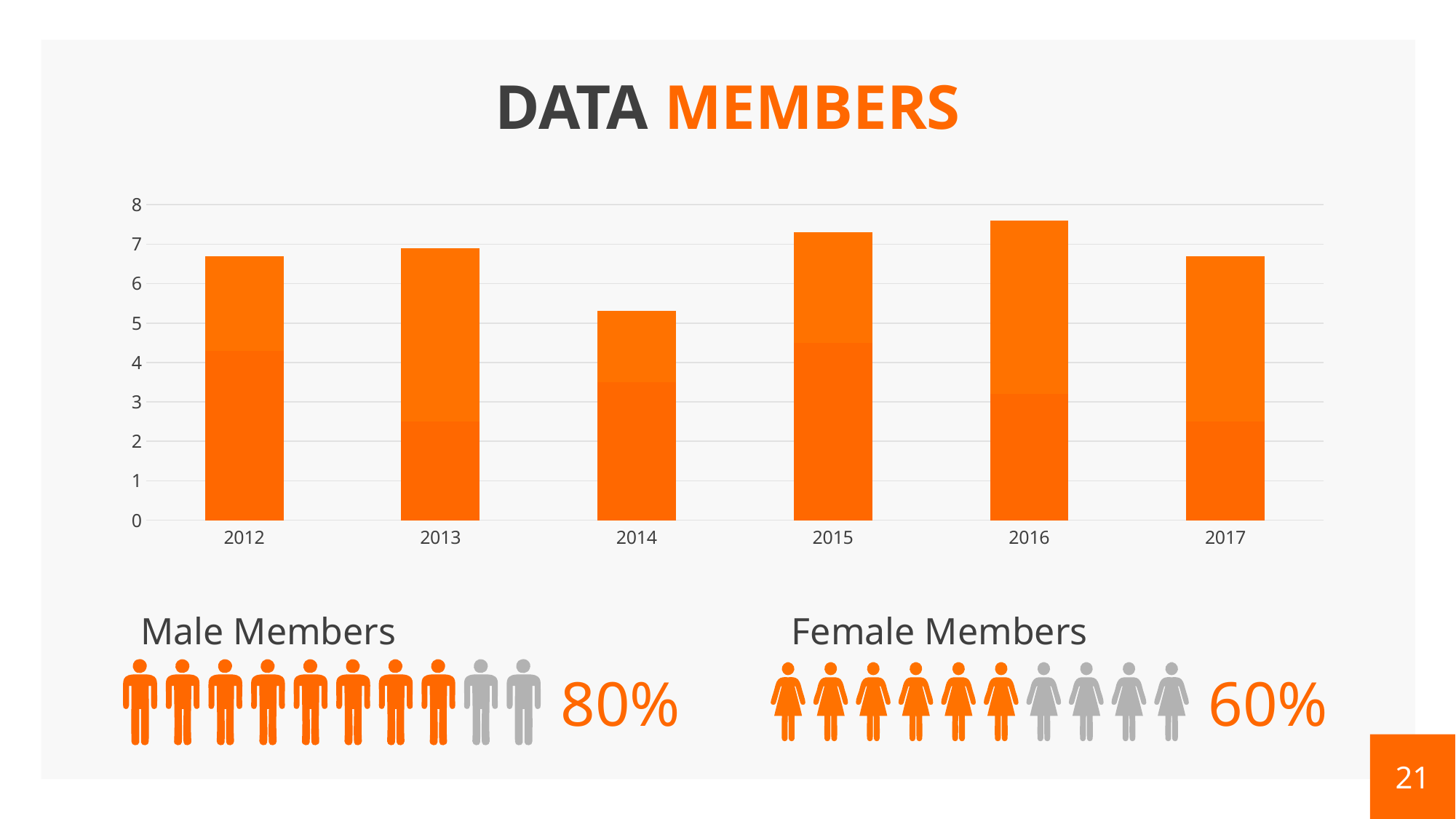
Which year has the tallest bar in the chart? 2016 Is the total bar value for 2012 greater or less than 6? greater Is the total bar value for 2017 greater or less than 7? less Is the total bar value for 2015 greater or less than 7? greater What is the title of the slide containing the chart? DATA MEMBERS Do the bar values rise or fall from 2014 to 2016? rise Which bar is taller, 2014 or 2015? 2015 How many years are shown on the x axis of the chart? 6 What kind of chart is shown on the slide? bar chart Which year has the shortest bar in the chart? 2014